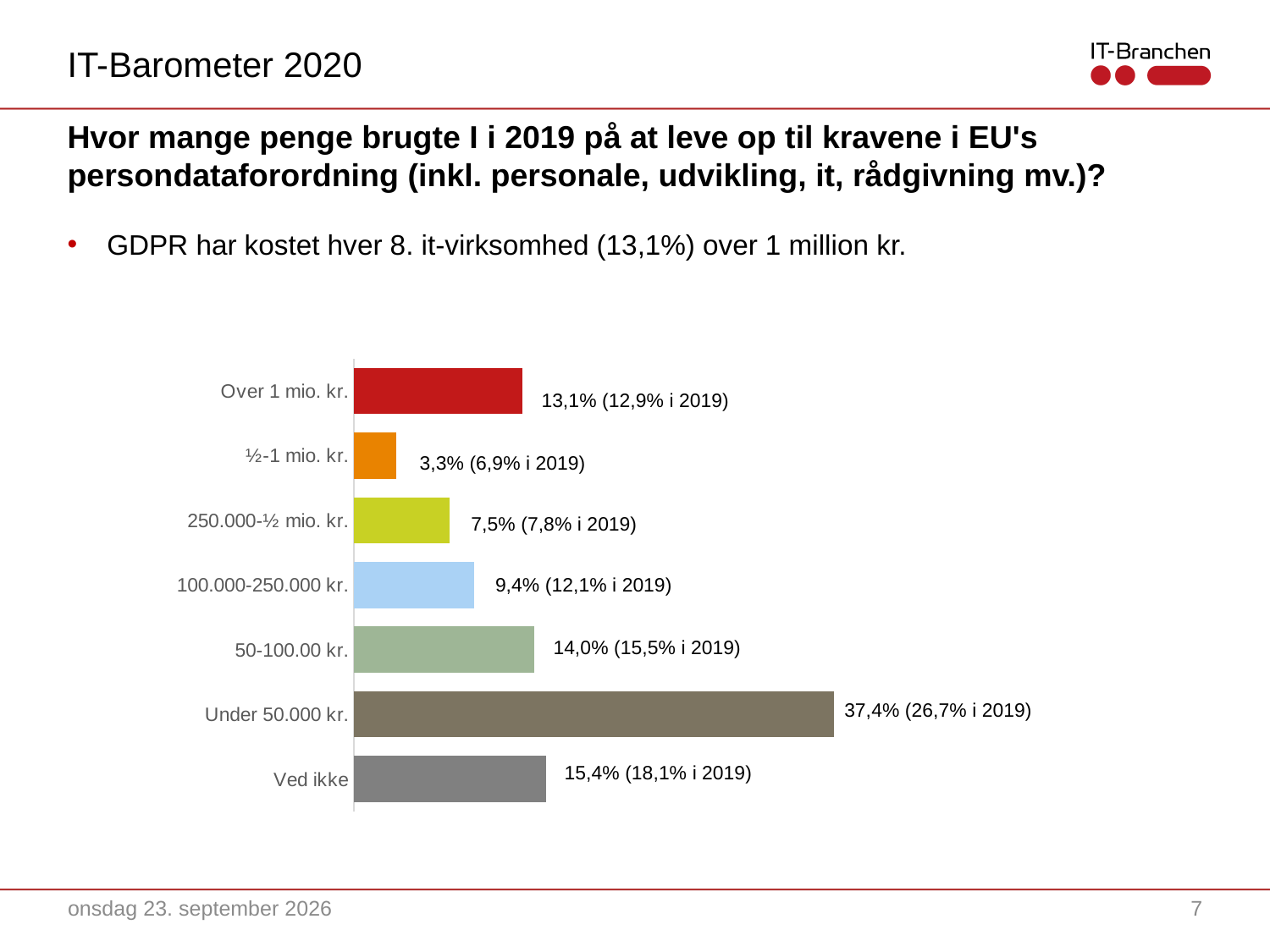
Which category has the lowest value in the chart? ½-1 mio. kr. What colour is the bar for 'Over 1 mio. kr.'? Red Which category has the highest value in the chart? Under 50.000 kr. What type of chart is shown on the slide? Bar chart What percentage of companies spent over 1 mio. kr. (Over 1 mio. kr.) according to the chart? 13,1% What was the 2019 value shown in parentheses for 'Ved ikke'? 18,1% What is the value shown for 'Under 50.000 kr.'? 37,4% By how many percentage points did the 'Under 50.000 kr.' share change from 2019 (26,7%) to the current value (37,4%)? 10,7 percentage points Which is larger: the value for '50-100.00 kr.' or the value for 'Over 1 mio. kr.'? 50-100.00 kr. What is the value shown for '½-1 mio. kr.'? 3,3% How many categories are shown in the chart? 7 What is the difference in percentage points between 'Under 50.000 kr.' (37,4%) and 'Ved ikke' (15,4%)? 22,0 percentage points